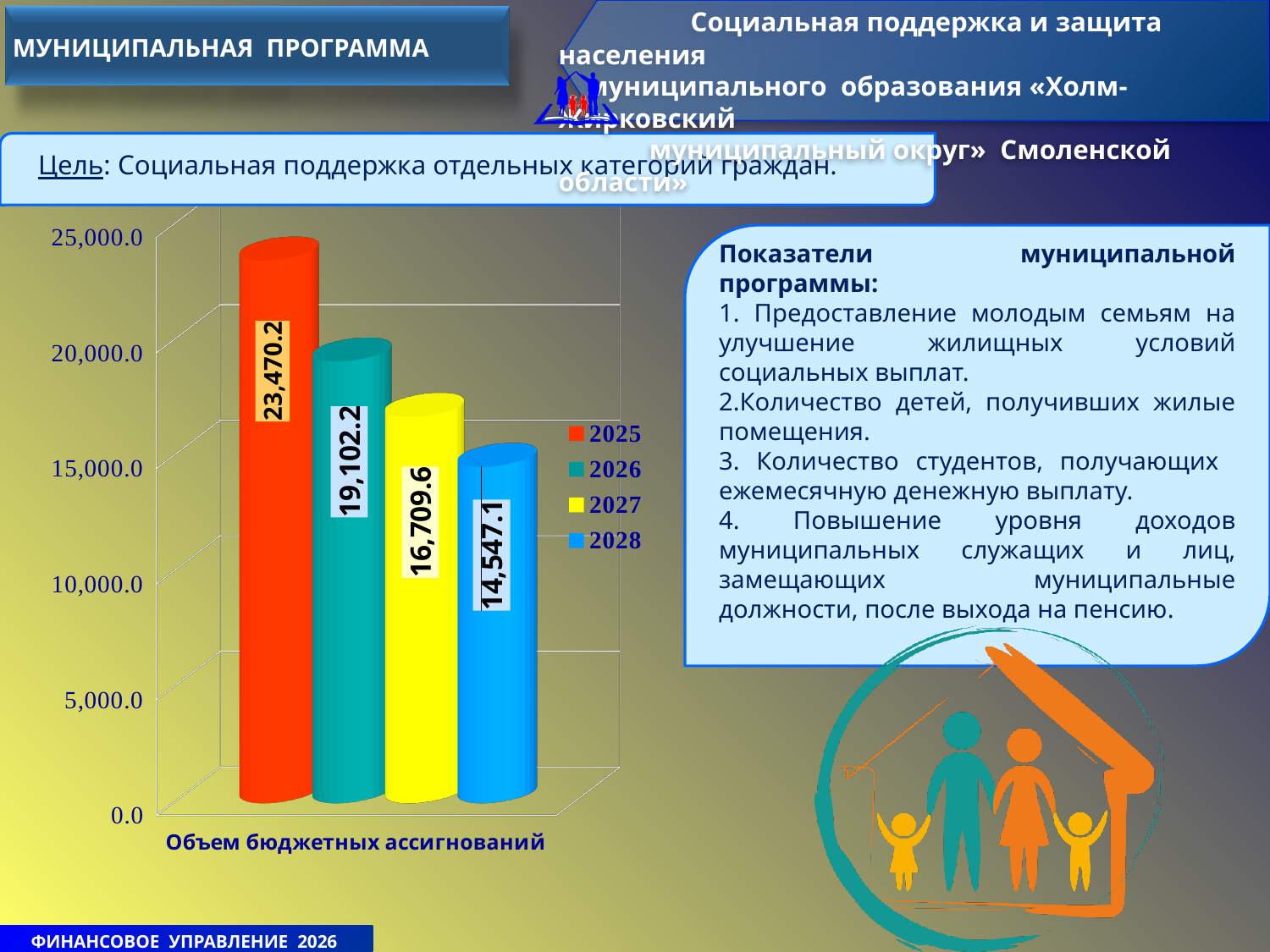
Which year has the lowest value in the chart? 2028 What is the difference between the values for 2025 and 2028? 8,923.1 Which is larger, the value for 2026 or the value for 2027? 2026 What kind of chart is shown on the slide? bar chart How many series does the legend list? 4 What is the value for 2028 in the chart? 14,547.1 Is the value for 2027 greater or less than 15,000.0? greater Which year has the highest value in the chart? 2025 What is the value for 2025 in the chart? 23,470.2 Do the values rise or fall from 2025 to 2028? fall What is the value for 2026 in the chart? 19,102.2 What is the value for 2027 in the chart? 16,709.6